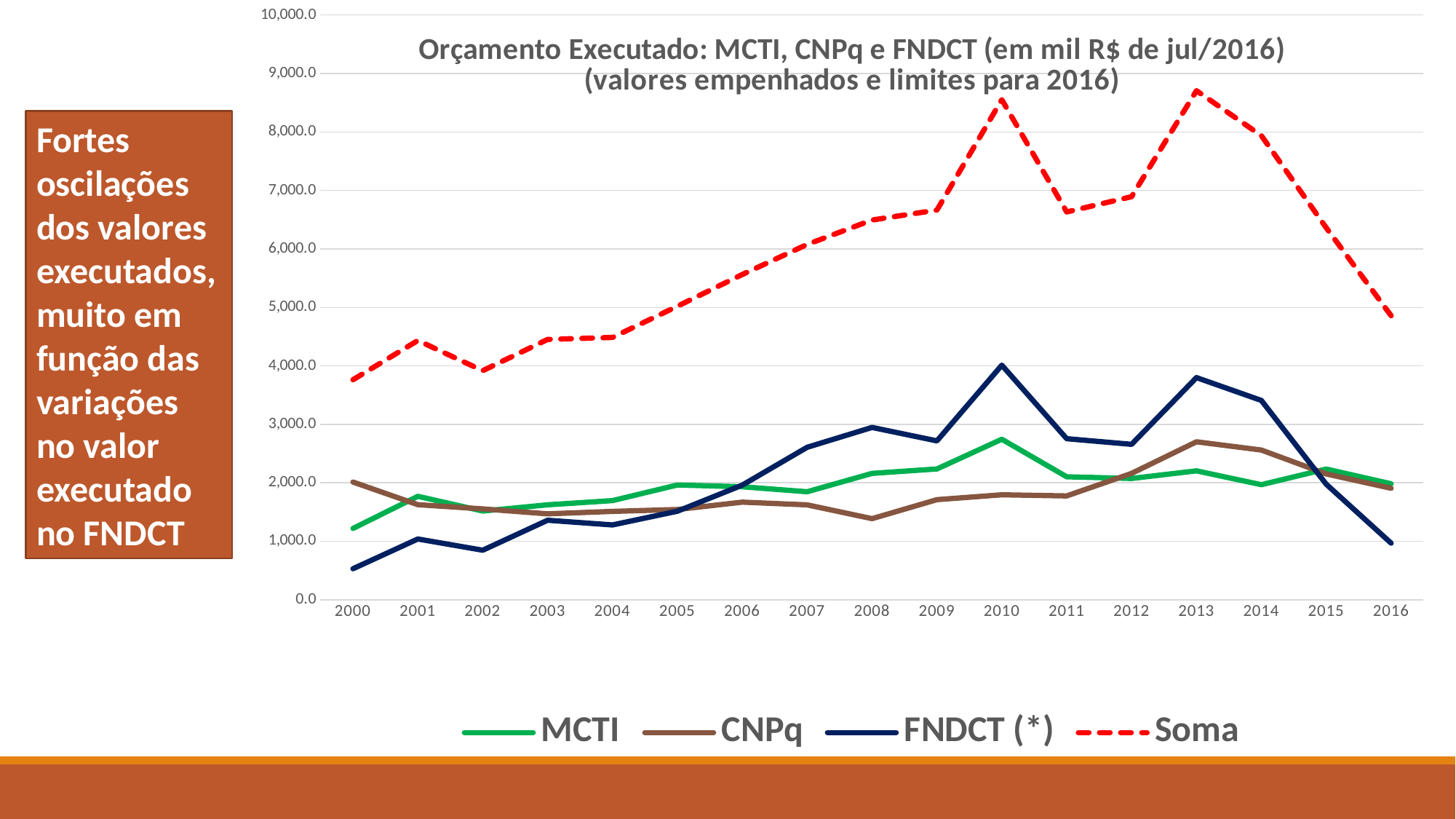
Is the value for MCTI in 2010 greater or less than 2,500.0? greater Does the Soma series rise or fall from 2013 to 2016? fall Is the value for Soma in 2016 greater or less than 5,000.0? less Is the value for Soma in 2010 greater or less than 8,000.0? greater How many years are shown along the x axis? 17 Which series is drawn as a red dashed line? Soma In 2016, which is larger, the value for MCTI or the value for FNDCT (*)? MCTI In which year is the value for FNDCT (*) lowest? 2000 How many series does the legend list? 4 In 2000, which is larger, the value for CNPq or the value for MCTI? CNPq What kind of chart is shown on the slide? line chart